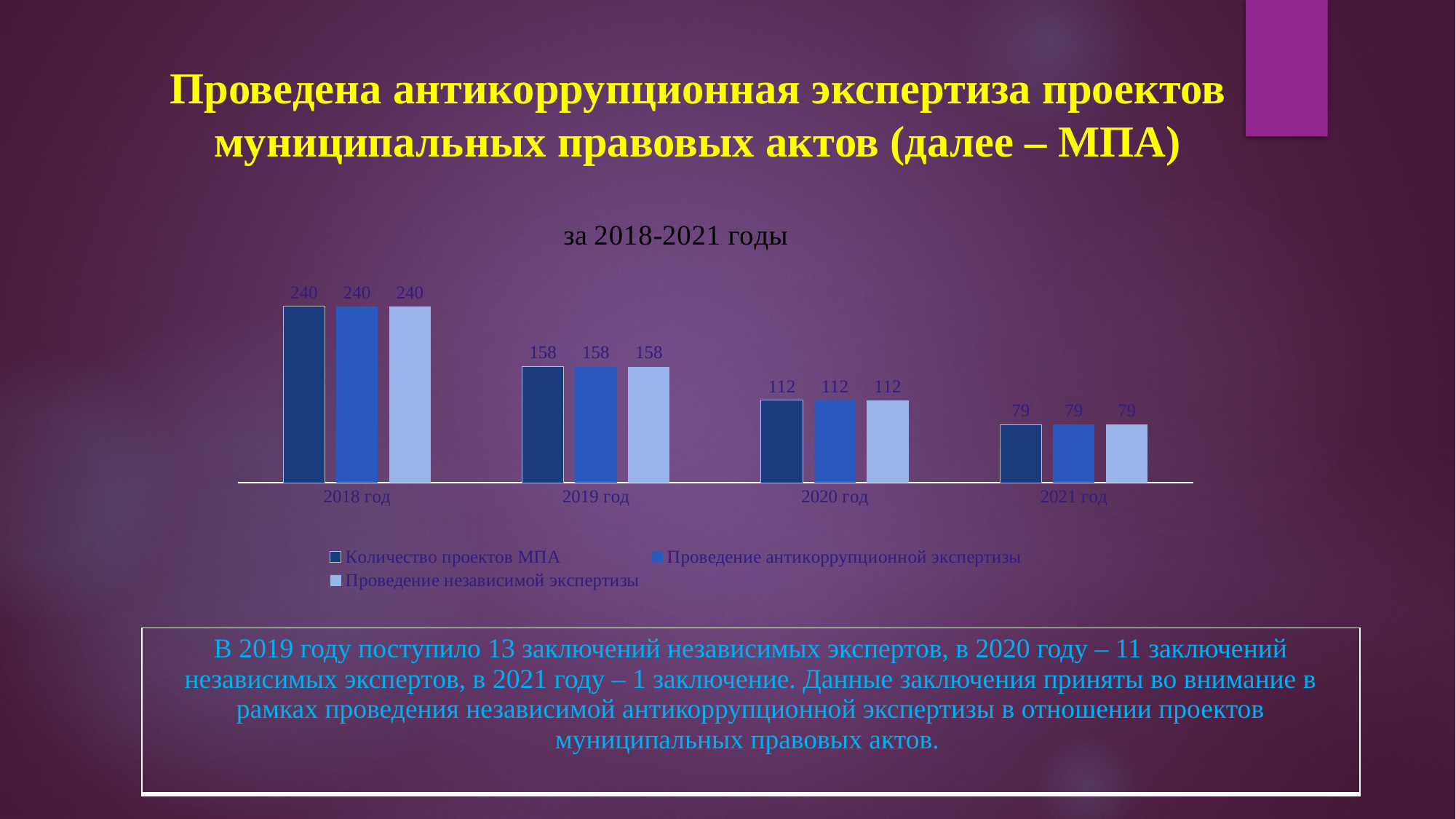
Which is larger: the "Количество проектов МПА" value for 2019 год or for 2020 год? 2019 год What kind of chart is shown on the slide? Bar chart What is the value for "Проведение независимой экспертизы" in 2021 год? 79 Which year has the lowest value for "Проведение антикоррупционной экспертизы"? 2021 год What is the value for "Количество проектов МПА" in 2019 год? 158 What is the difference between the "Проведение независимой экспертизы" values for 2020 год and 2021 год? 33 How many series does the legend list? 3 How many year categories are shown on the x axis? 4 What is the value for "Проведение антикоррупционной экспертизы" in 2020 год? 112 What is the difference between the "Количество проектов МПА" values for 2018 год and 2019 год? 82 What is the value for "Количество проектов МПА" in 2018 год? 240 Which year has the highest value for "Количество проектов МПА"? 2018 год